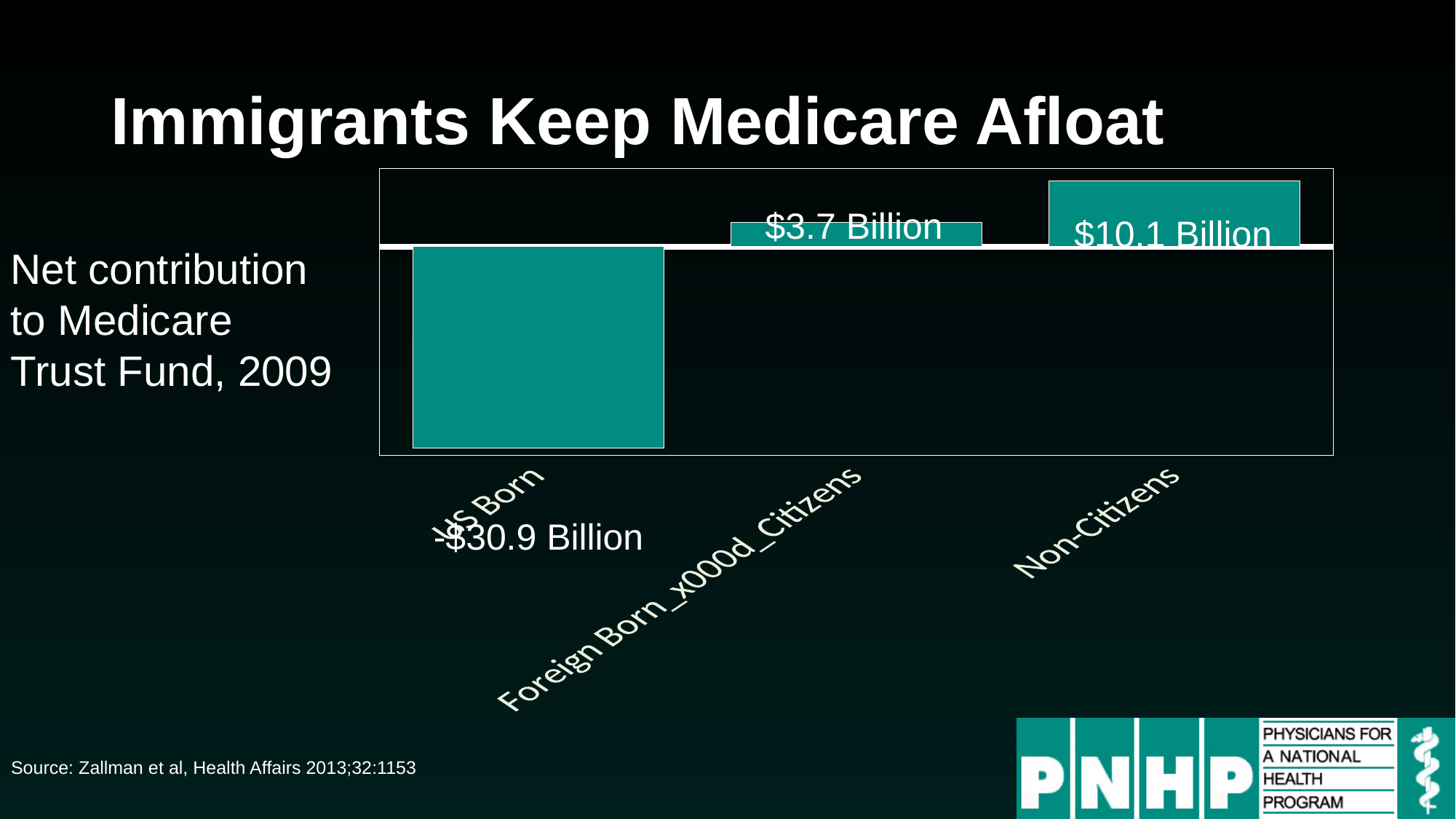
How many categories are shown in the chart? 3 Which category's bar extends below the zero line? US Born Do the values rise or fall moving from left to right across the categories? Rise What is the net contribution to the Medicare Trust Fund for Foreign Born Citizens (the middle bar)? $3.7 Billion Which is larger, the net contribution of Non-Citizens or of Foreign Born Citizens? Non-Citizens How much larger is the net contribution of Non-Citizens than that of Foreign Born Citizens? $6.4 Billion Which category has the highest net contribution to the Medicare Trust Fund? Non-Citizens What is the net contribution to the Medicare Trust Fund for Non-Citizens? $10.1 Billion What kind of chart is shown on the slide? Bar chart What is the title of the slide containing the chart? Immigrants Keep Medicare Afloat Which category has the lowest net contribution to the Medicare Trust Fund? US Born What is the net contribution to the Medicare Trust Fund for US Born? -$30.9 Billion